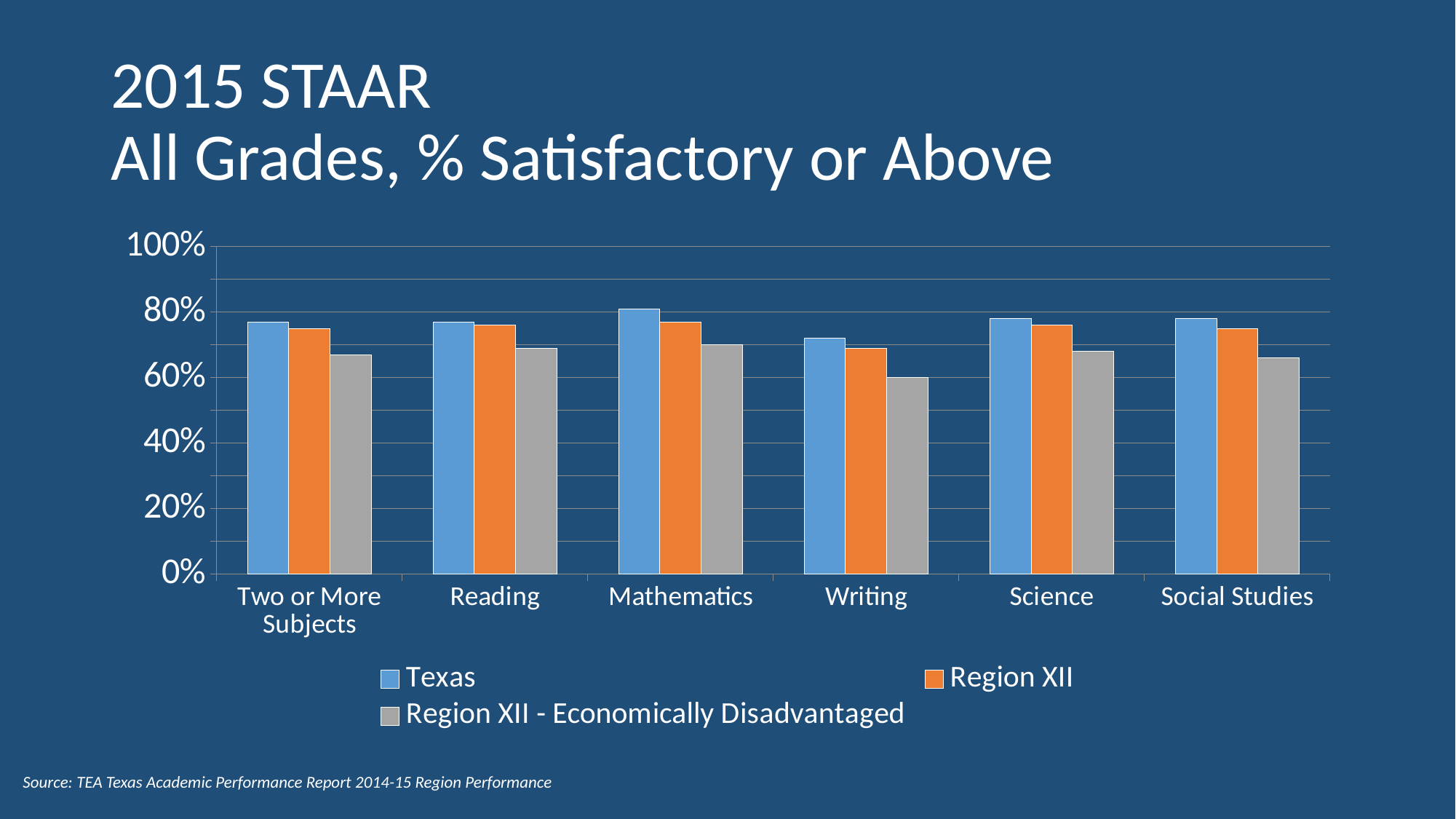
For Writing, which is larger: the Texas value or the Region XII - Economically Disadvantaged value? Texas How many series does the legend list? 3 How many subject categories are shown on the x axis? 6 Is the Region XII value for Science greater or less than 60%? greater Is the Texas value for Writing greater or less than 80%? less Is the Region XII - Economically Disadvantaged value for Social Studies greater or less than 60%? greater For Mathematics, which is larger: the Region XII value or the Region XII - Economically Disadvantaged value? Region XII For which subject is the Texas value highest? Mathematics For which subject is the Texas value lowest? Writing Which series is shown in orange? Region XII For which subject is the Region XII - Economically Disadvantaged value lowest? Writing What kind of chart is shown on the slide? bar chart